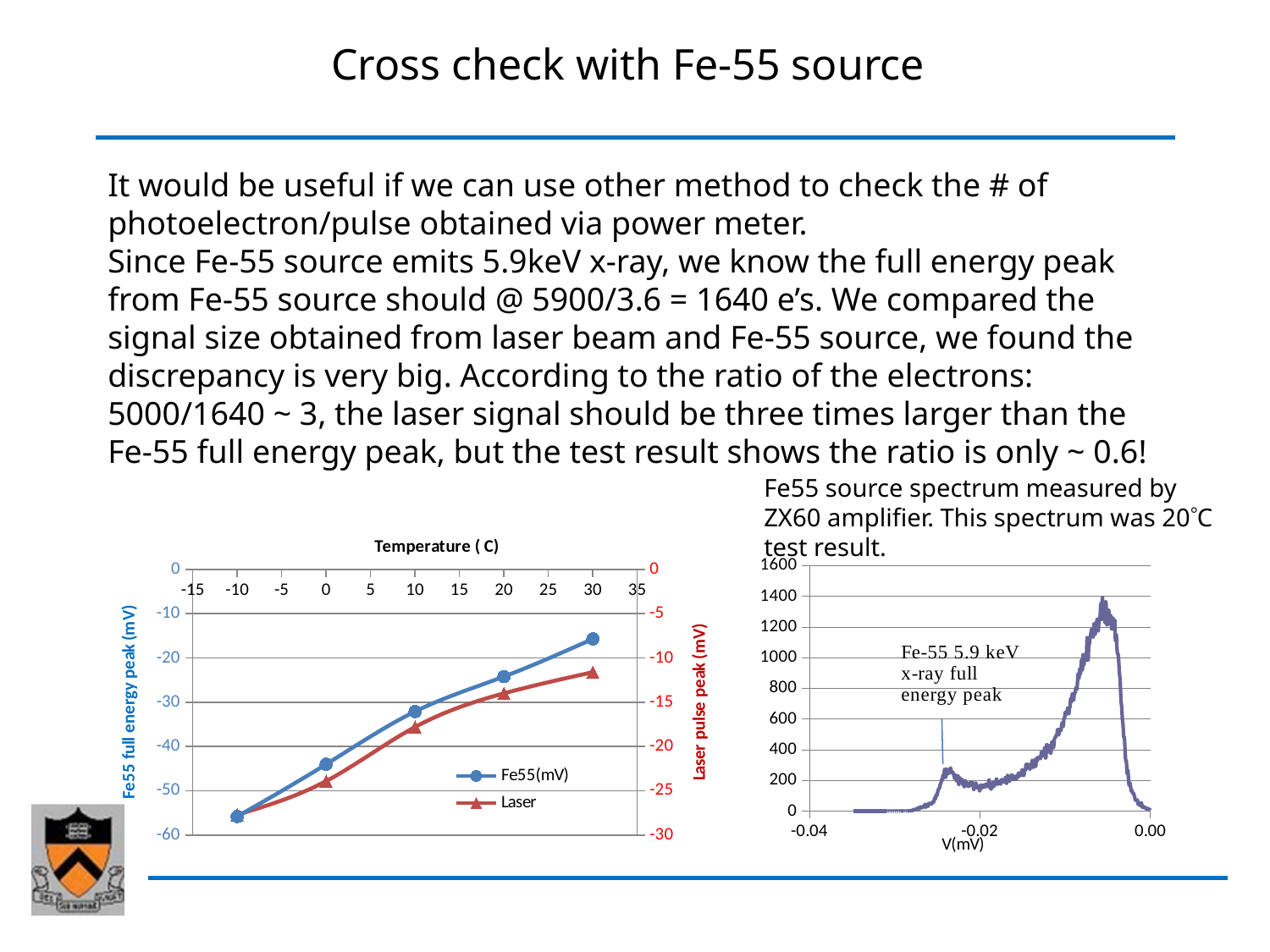
In the left chart (Temperature ( C)), is the Fe55(mV) value at -10 greater or less than -50 on the left axis? less In the left chart (Temperature ( C)), is the Fe55(mV) value at 30 greater or less than -20 on the left axis? greater In the left chart (Temperature ( C)), do the Fe55(mV) values rise or fall as temperature increases? rise In the left chart (Temperature ( C)), at which temperature is the Laser value lowest? -10 In the left chart (Temperature ( C)), is the Laser value at 30 greater or less than -15 on the right axis? greater In the left chart (Temperature ( C)), how many data points does the Fe55(mV) series have? 5 In the right chart (Fe55 source spectrum), what is the label of the x axis? V(mV) In the left chart (Temperature ( C)), how many series does the legend list? 2 In the left chart (Temperature ( C)), at which temperature is the Fe55(mV) value highest? 30 In the left chart (Temperature ( C)), what is the title of the left vertical axis? Fe55 full energy peak (mV) What kind of chart is the left chart with the x axis titled Temperature ( C)? line chart